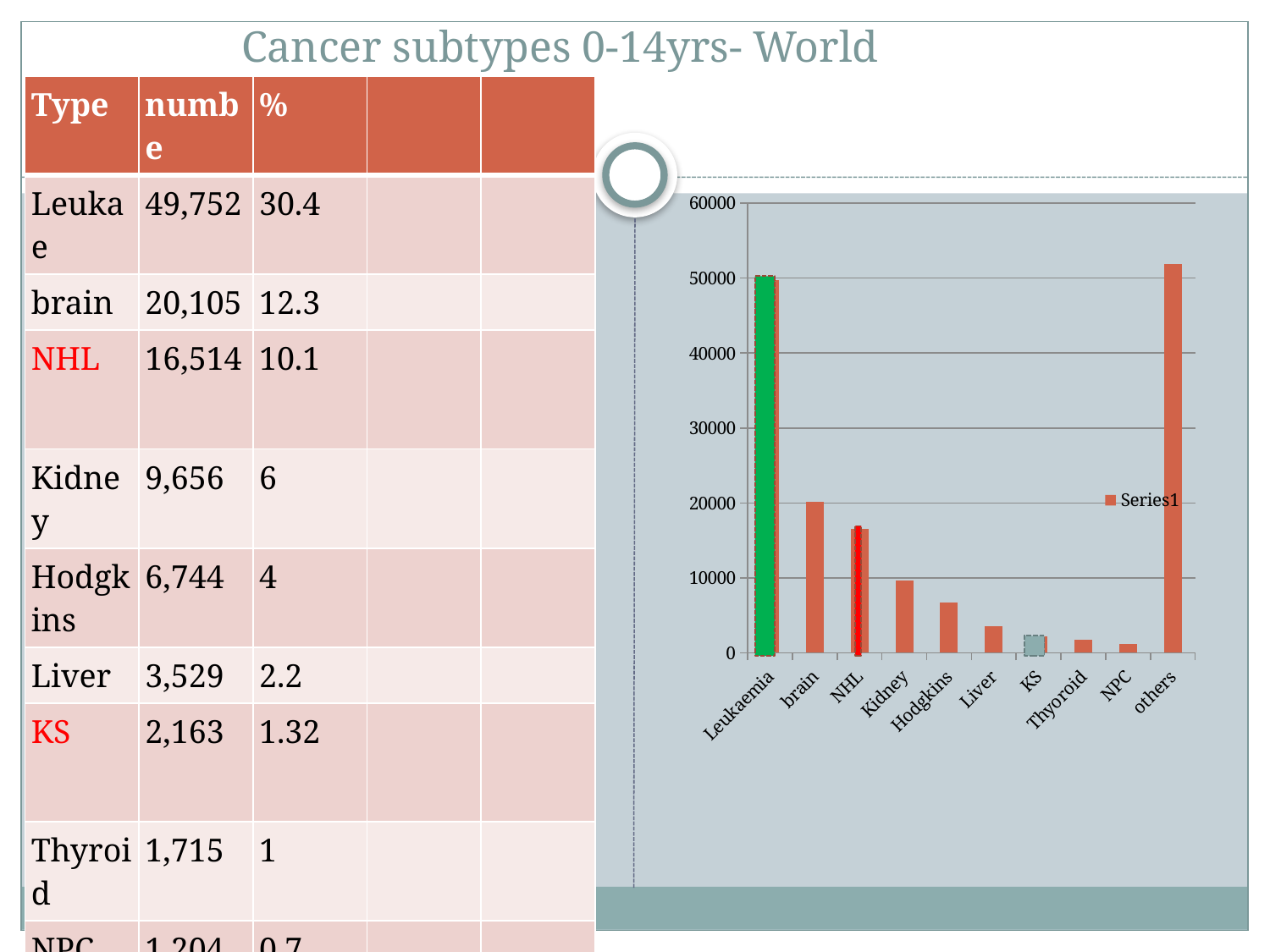
Is the value for brain greater or less than 10000? greater What colour is the Leukaemia bar in the chart? green Which has the larger value in the chart, Leukaemia or brain? Leukaemia Is the value for brain greater or less than 30000? less What is the name of the series shown in the chart legend? Series1 Is the value for Leukaemia greater or less than 40000? greater How many series does the chart legend list? 1 Which has the larger value in the chart, Kidney or Liver? Kidney What kind of chart is shown on the slide? bar chart How many categories are plotted on the x axis of the chart? 10